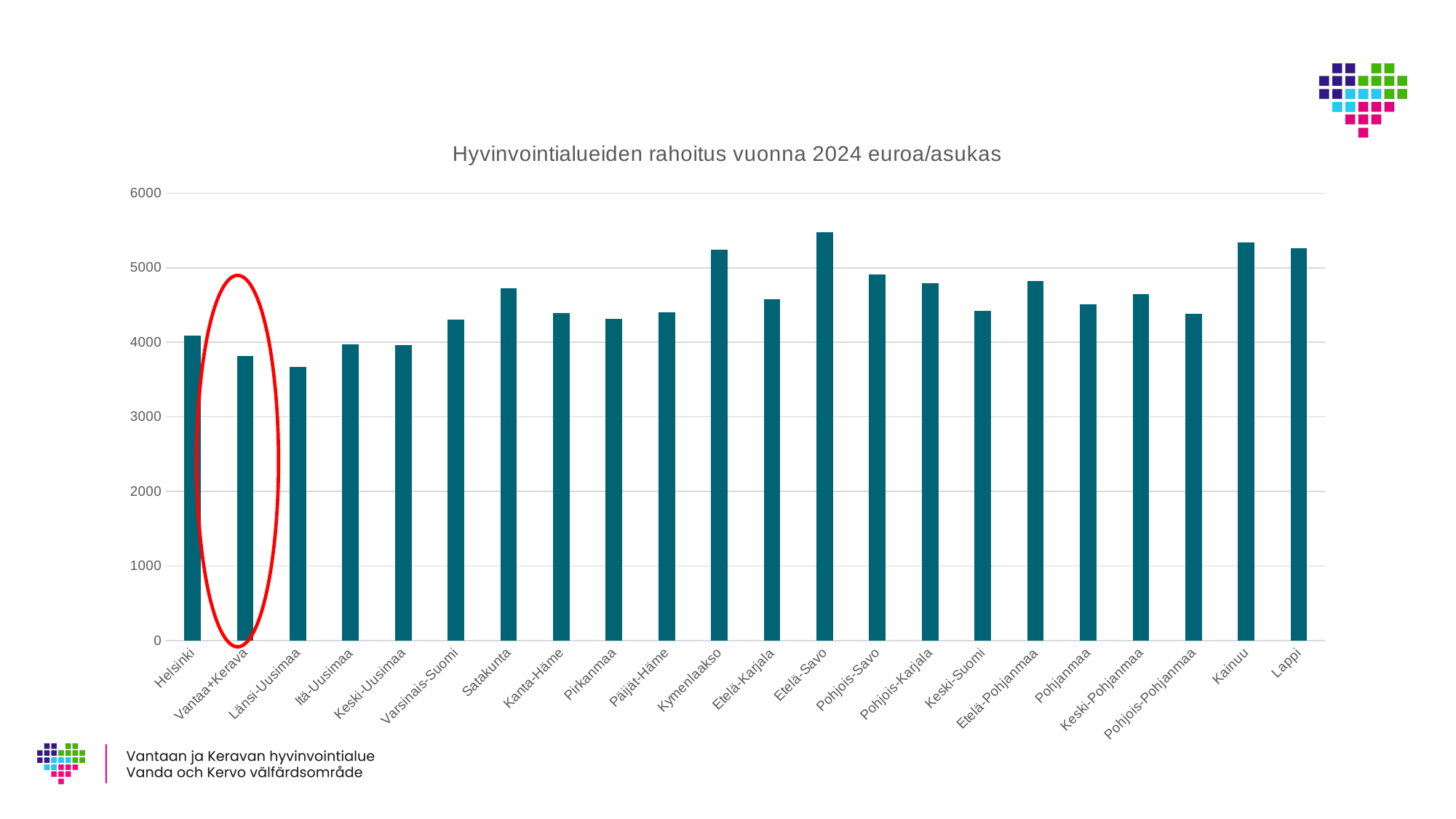
Is the value for Satakunta greater or less than 5000? less How many regions (bars) are shown in the chart? 22 Which is larger, the value for Helsinki or the value for Vantaa+Kerava? Helsinki Which bar is highlighted with a red circle on the slide? Vantaa+Kerava Which region has the highest value in the chart? Etelä-Savo Is the value for Lappi greater or less than 5000? greater What is the title of the chart? Hyvinvointialueiden rahoitus vuonna 2024 euroa/asukas What kind of chart is shown on the slide? bar chart Which region has the lowest value in the chart? Länsi-Uusimaa Which is larger, the value for Kymenlaakso or the value for Etelä-Karjala? Kymenlaakso Is the value for Kymenlaakso greater or less than 5000? greater